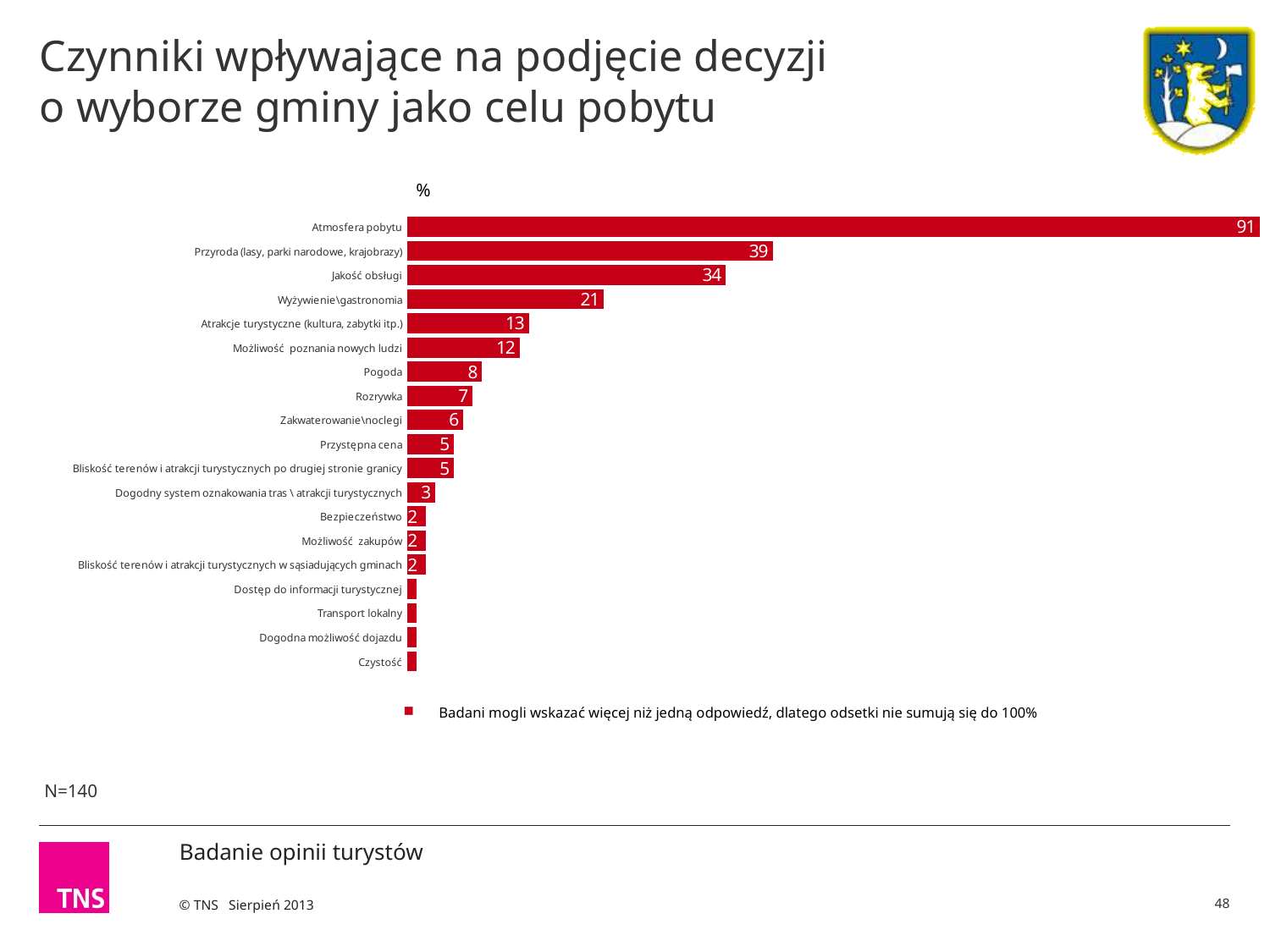
Which category has the highest value? Atmosfera pobytu What is the value for Atmosfera pobytu? 91 What is the value for Pogoda? 8 What kind of chart is shown on the slide? bar chart Which is larger, the value for Atrakcje turystyczne (kultura, zabytki itp.) or the value for Możliwość poznania nowych ludzi? Atrakcje turystyczne (kultura, zabytki itp.) What is the difference between the values for Jakość obsługi and Wyżywienie\gastronomia? 13 What is the sample size (N) stated on the slide? N=140 How many categories are shown in the chart? 19 What is the value for Jakość obsługi? 34 What is the value for Wyżywienie\gastronomia? 21 What is the difference between the values for Atmosfera pobytu and Przyroda (lasy, parki narodowe, krajobrazy)? 52 What is the value for Przyroda (lasy, parki narodowe, krajobrazy)? 39